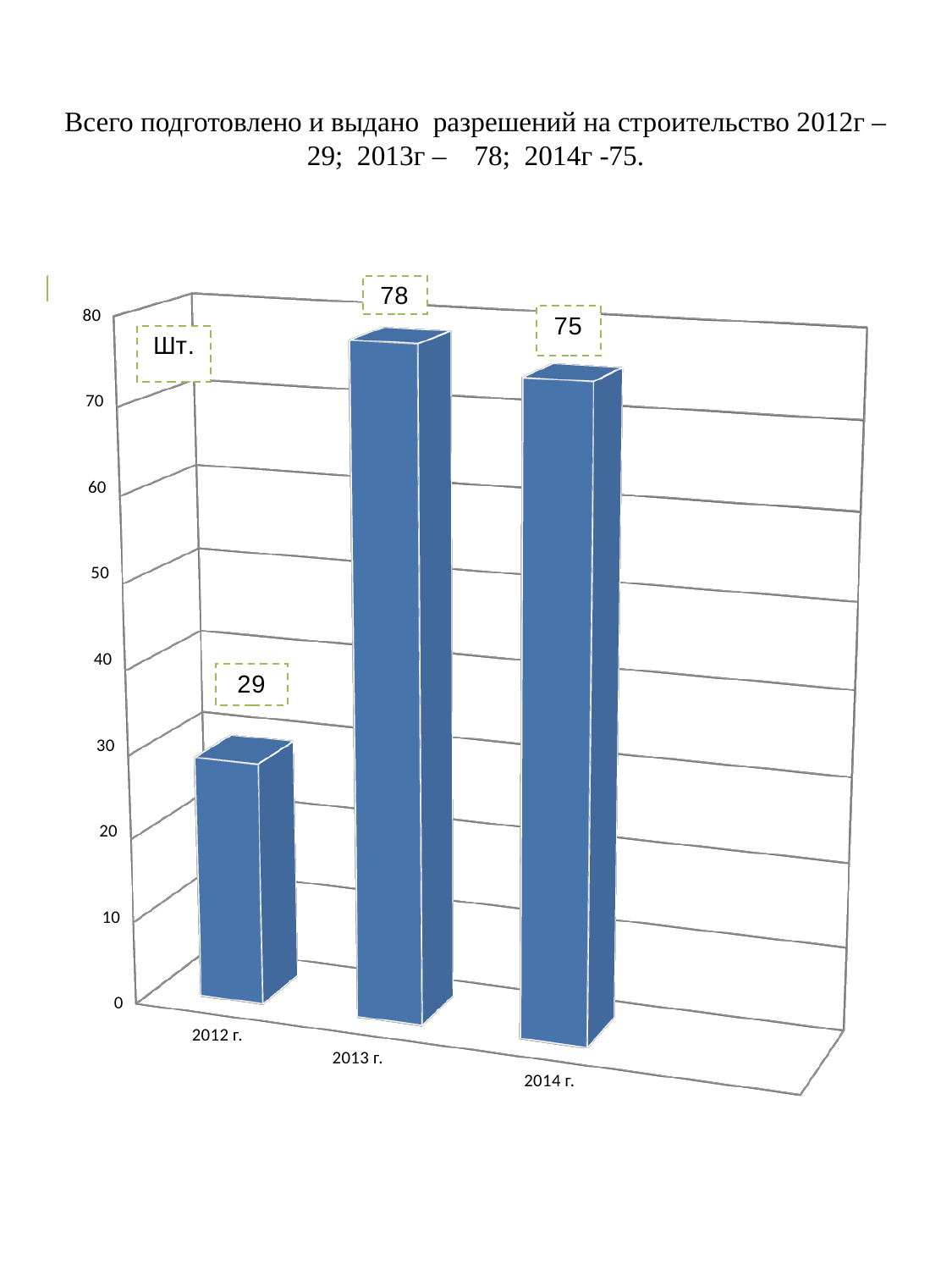
Which is larger, the value for 2012 г. or the value for 2014 г.? 2014 г. What is the difference between the values for 2013 г. and 2012 г.? 49 What unit label is shown in the box at the top left of the chart? Шт. What is the value for 2012 г.? 29 What is the value for 2013 г.? 78 What kind of chart is shown on the slide? bar chart How many categories are shown on the x axis? 3 Which year has the highest value? 2013 г. What is the difference between the values for 2013 г. and 2014 г.? 3 What is the value for 2014 г.? 75 Is the value for 2012 г. greater or less than 40? less Which year has the lowest value? 2012 г.